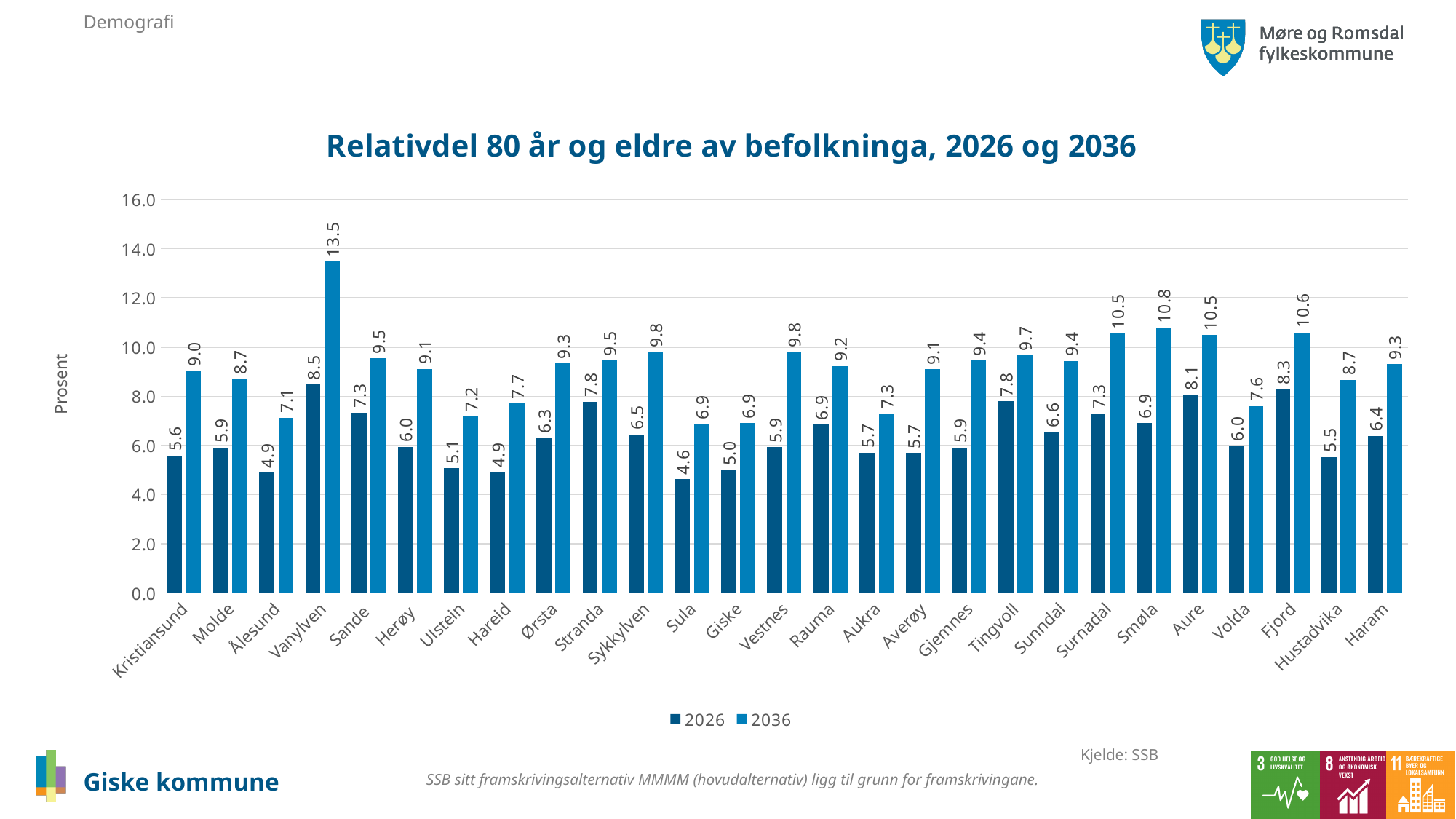
Is the 2036 value for Surnadal greater or less than 10.0? greater Which municipality has the highest 2036 value? Vanylven What is the 2036 value for Smøla? 10.8 What is the 2026 value for Giske? 5.0 How many series does the legend list? 2 Which municipality has the lowest 2026 value? Sula What kind of chart is shown? bar chart Which is larger, the 2026 value for Fjord or the 2026 value for Aure? Fjord What is the difference between the 2036 and 2026 values for Kristiansund? 3.4 What is the label on the y axis? Prosent What is the 2036 value for Vanylven? 13.5 How many municipalities are shown on the x axis? 27